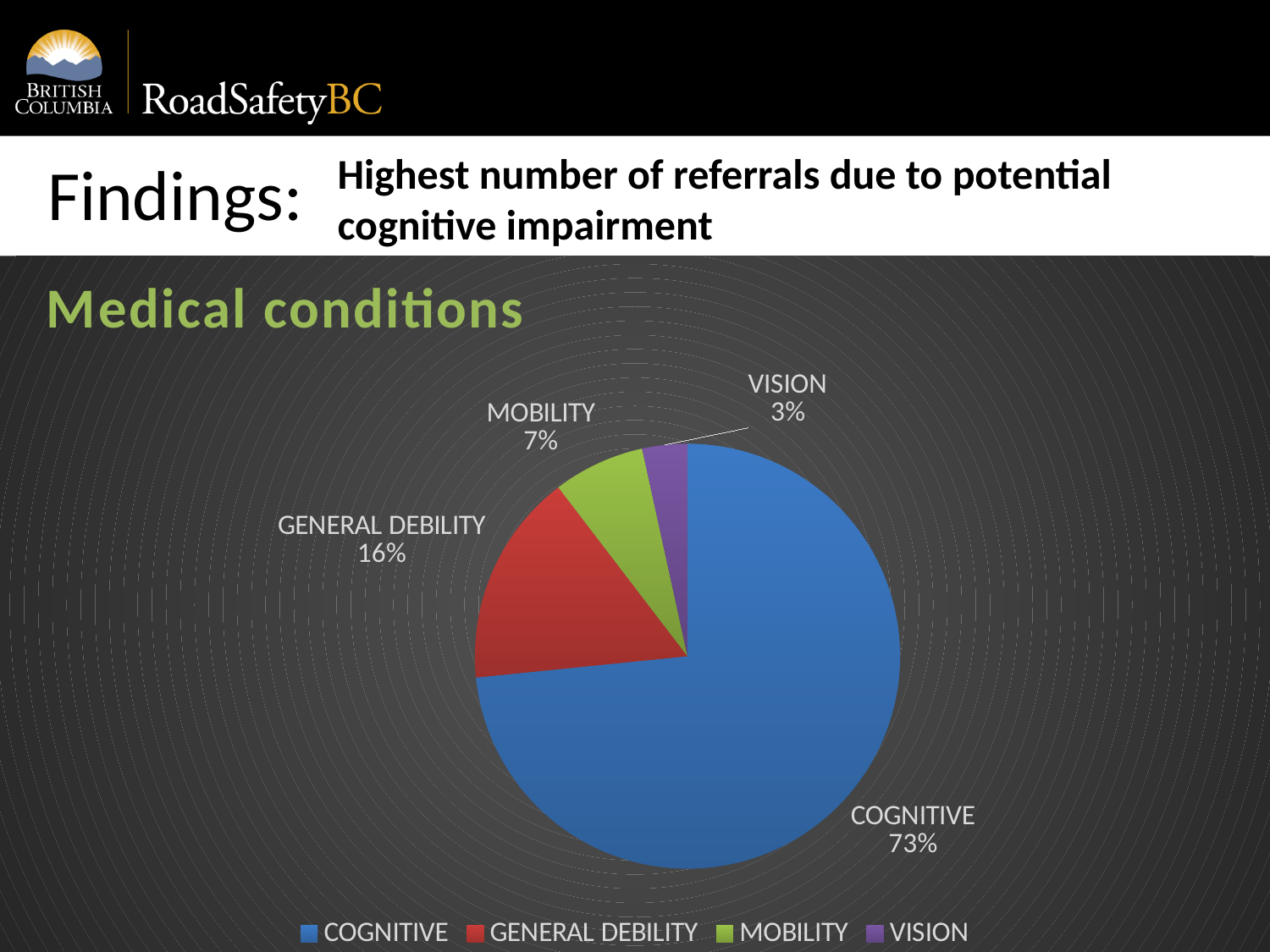
What share of the pie does COGNITIVE represent? 73% What is the value shown for MOBILITY? 7% What is the value shown for VISION? 3% Which category has the largest slice of the pie? COGNITIVE What is the difference between the COGNITIVE and GENERAL DEBILITY percentages? 57% What is the title of the chart? Medical conditions Which category has the smallest slice of the pie? VISION Which is larger, GENERAL DEBILITY or MOBILITY? GENERAL DEBILITY How many categories are shown in the pie chart? 4 What is the value shown for GENERAL DEBILITY? 16% What is the difference between the MOBILITY and VISION percentages? 4% What type of chart is shown on the slide? pie chart